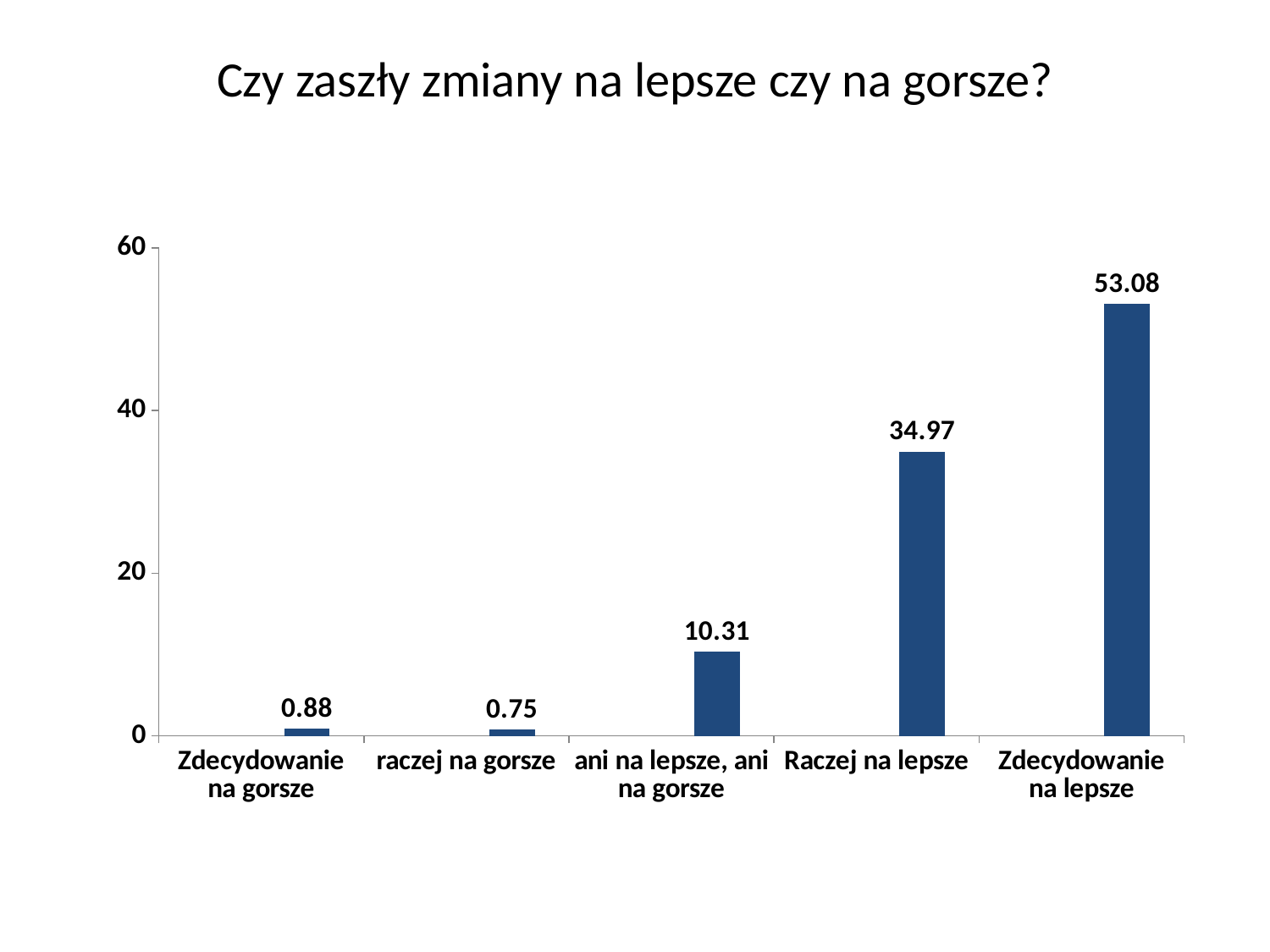
What is the value for "Zdecydowanie na gorsze"? 0.88 Which is larger, the value for "Raczej na lepsze" or the value for "ani na lepsze, ani na gorsze"? Raczej na lepsze What is the value for "raczej na gorsze"? 0.75 What is the title of the chart? Czy zaszły zmiany na lepsze czy na gorsze? Which category has the highest value? Zdecydowanie na lepsze Is the value for "Zdecydowanie na lepsze" greater or less than 40? greater How many categories are shown on the x axis? 5 What is the value for "ani na lepsze, ani na gorsze"? 10.31 What is the difference between the values for "Zdecydowanie na lepsze" and "Raczej na lepsze"? 18.11 What is the value for "Zdecydowanie na lepsze"? 53.08 What kind of chart is shown on the slide? bar chart What is the value for "Raczej na lepsze"? 34.97